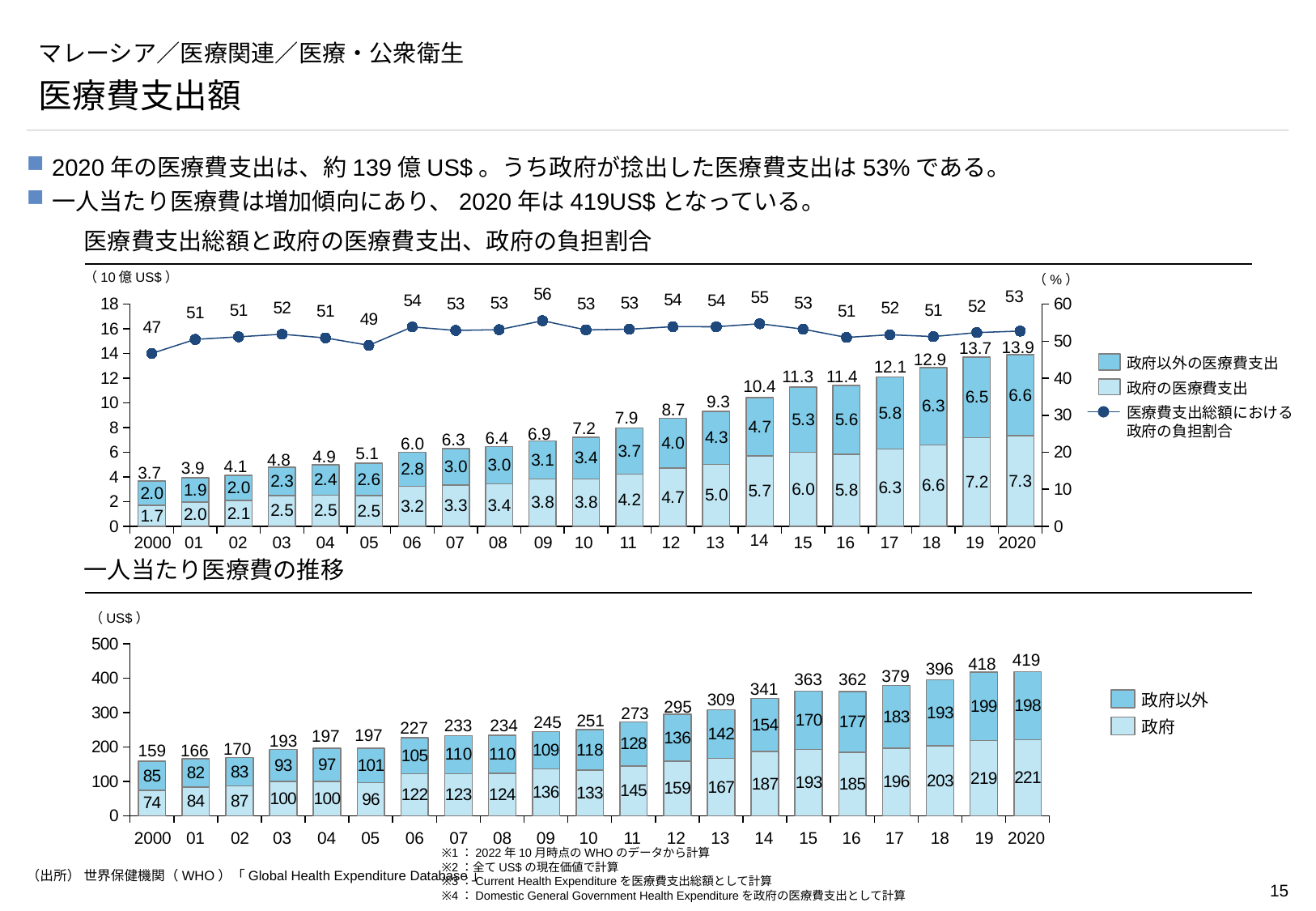
In the bottom chart (一人当たり医療費の推移), what is the 政府 value for 2020? 221 How many series does the legend of the top chart list? 3 In the top chart, in which year is the 政府の負担割合 line at its lowest value? 2000 In the bottom chart, what is the difference between the 2020 total (419) and the 2000 total (159)? 260 In the top chart, what is the total medical expenditure (stacked bar total) for 2020? 13.9 In the bottom chart, do the total per-capita values generally rise or fall from 2000 to 2020? Rise In the bottom chart, for 2014, which is larger: 政府 or 政府以外? 政府 In the top chart (医療費支出総額と政府の医療費支出、政府の負担割合), what is the value of 政府の医療費支出 for 2020? 7.3 In the top chart, in which year does the 政府の負担割合 line reach its highest value? 2009 What kind of chart is the bottom chart (一人当たり医療費の推移)? Stacked bar chart In the top chart, what is the difference between the total for 2020 (13.9) and the total for 2019 (13.7)? 0.2 How many years are plotted on the x axis of the bottom chart? 21